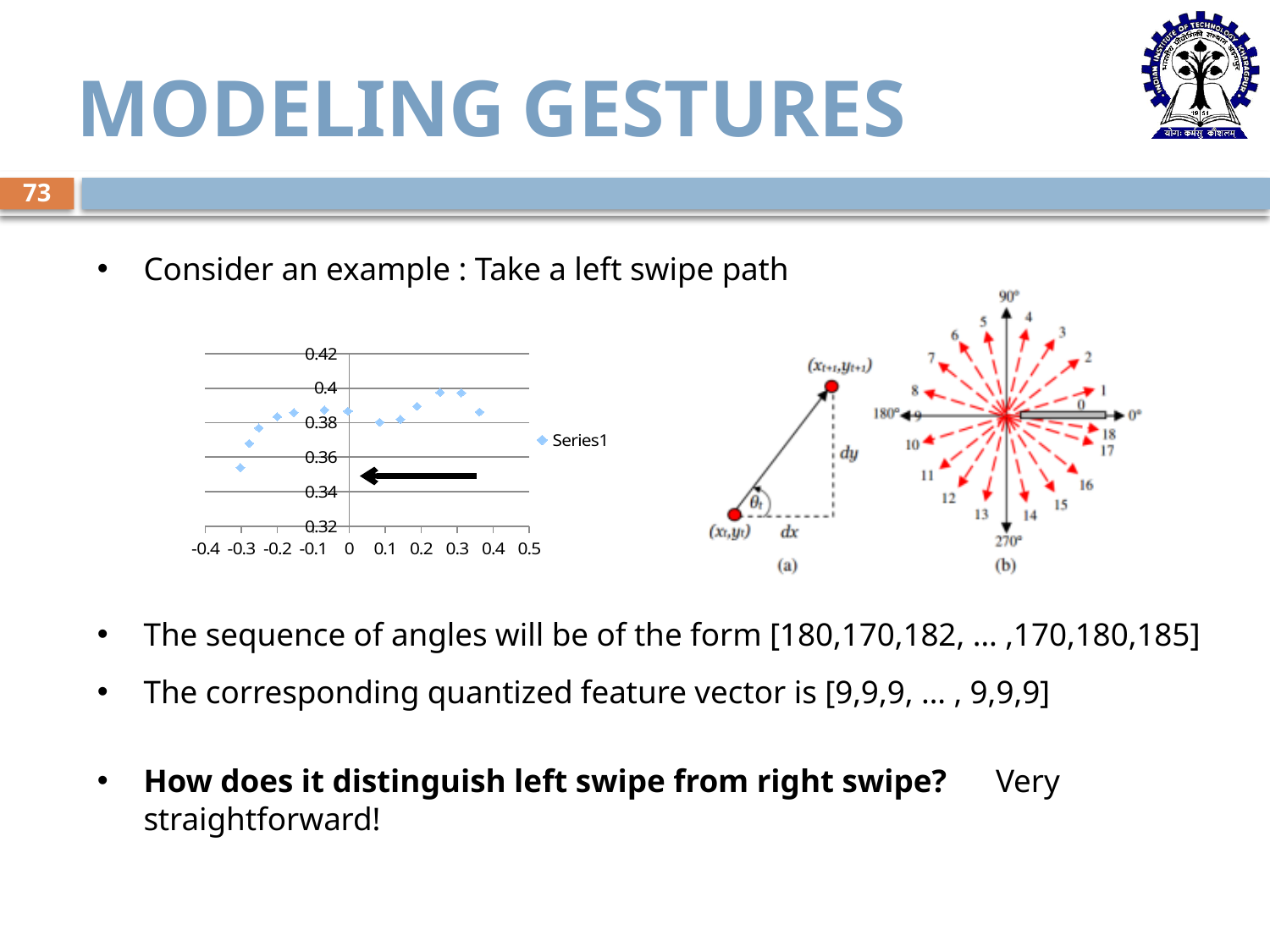
In the scatter chart, is the value of the lowest point greater or less than 0.34? greater In the scatter chart, do the values generally rise or fall as x increases from -0.3 to 0.3? rise In the scatter chart, is the value of the highest point greater or less than 0.38? greater What kind of chart is shown on the left of the slide? scatter chart What is the maximum value shown on the y axis of the scatter chart? 0.42 In the scatter chart, is the value of the leftmost point (near x = -0.3) greater or less than 0.38? less What is the name of the series shown in the scatter chart's legend? Series1 How many series does the legend of the scatter chart list? 1 In the scatter chart, is the point near x = -0.3 lower or higher than the point near x = 0.3? lower